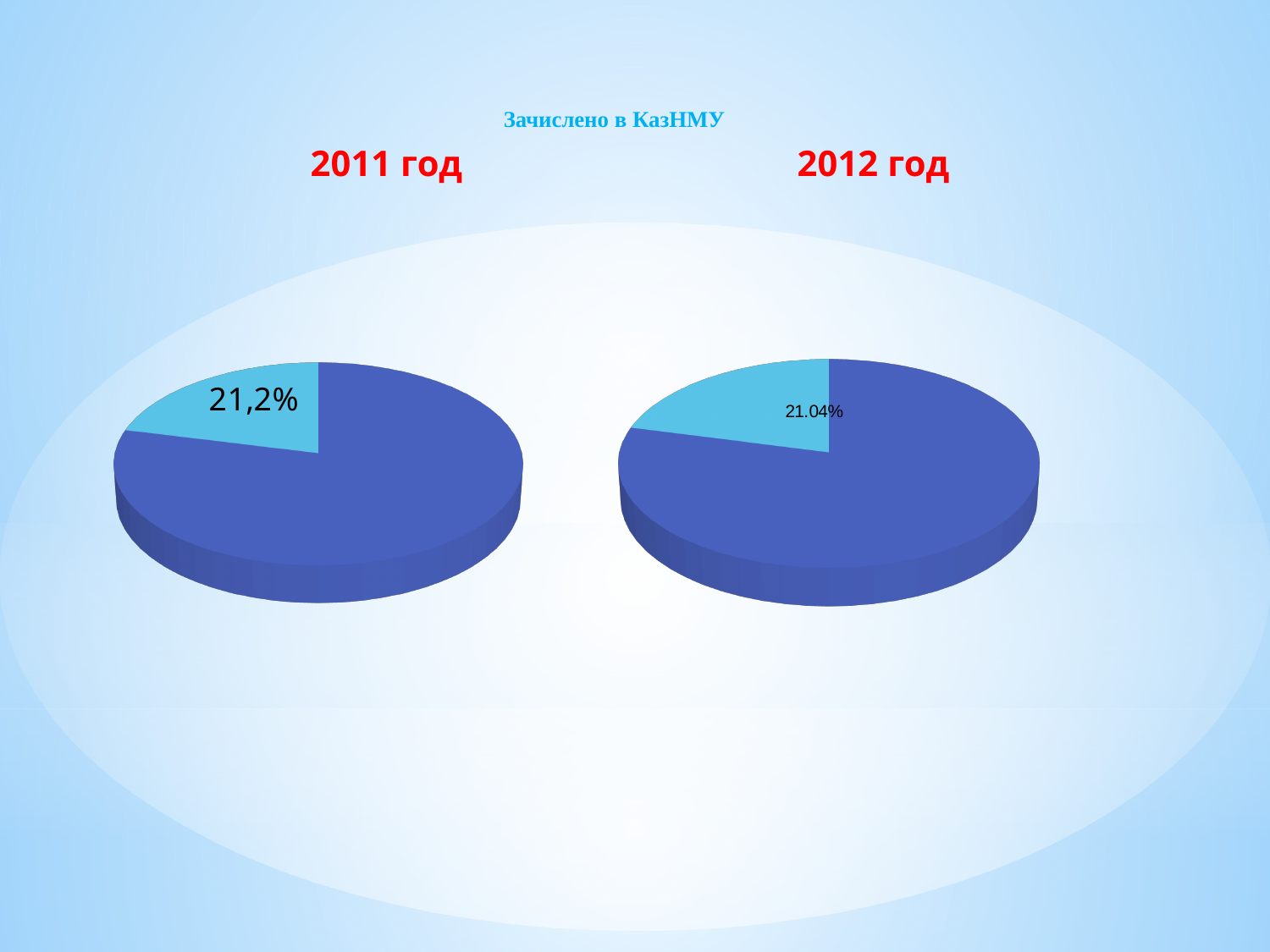
What kind of chart is the 2011 год chart? pie chart Comparing the labelled light blue slices, which year's slice has the larger printed share, 2011 год or 2012 год? 2011 год In the 2012 год pie chart, which slice is smaller, the dark blue one or the light blue one? the light blue one What is the share of the light blue slice in the 2012 год pie chart? 21.04% What is the overall title shown above the two pie charts? Зачислено в КазНМУ In the 2011 год pie chart, which slice is larger, the dark blue one or the light blue one? the dark blue one How many pie charts are shown on the slide? 2 How many slices does the 2011 год pie chart have? 2 How many slices does the 2012 год pie chart have? 2 What kind of chart is the 2012 год chart? pie chart In the 2012 год pie chart, what percentage is shown on the light blue slice? 21.04% In the 2011 год pie chart, what percentage is shown on the light blue slice? 21,2%